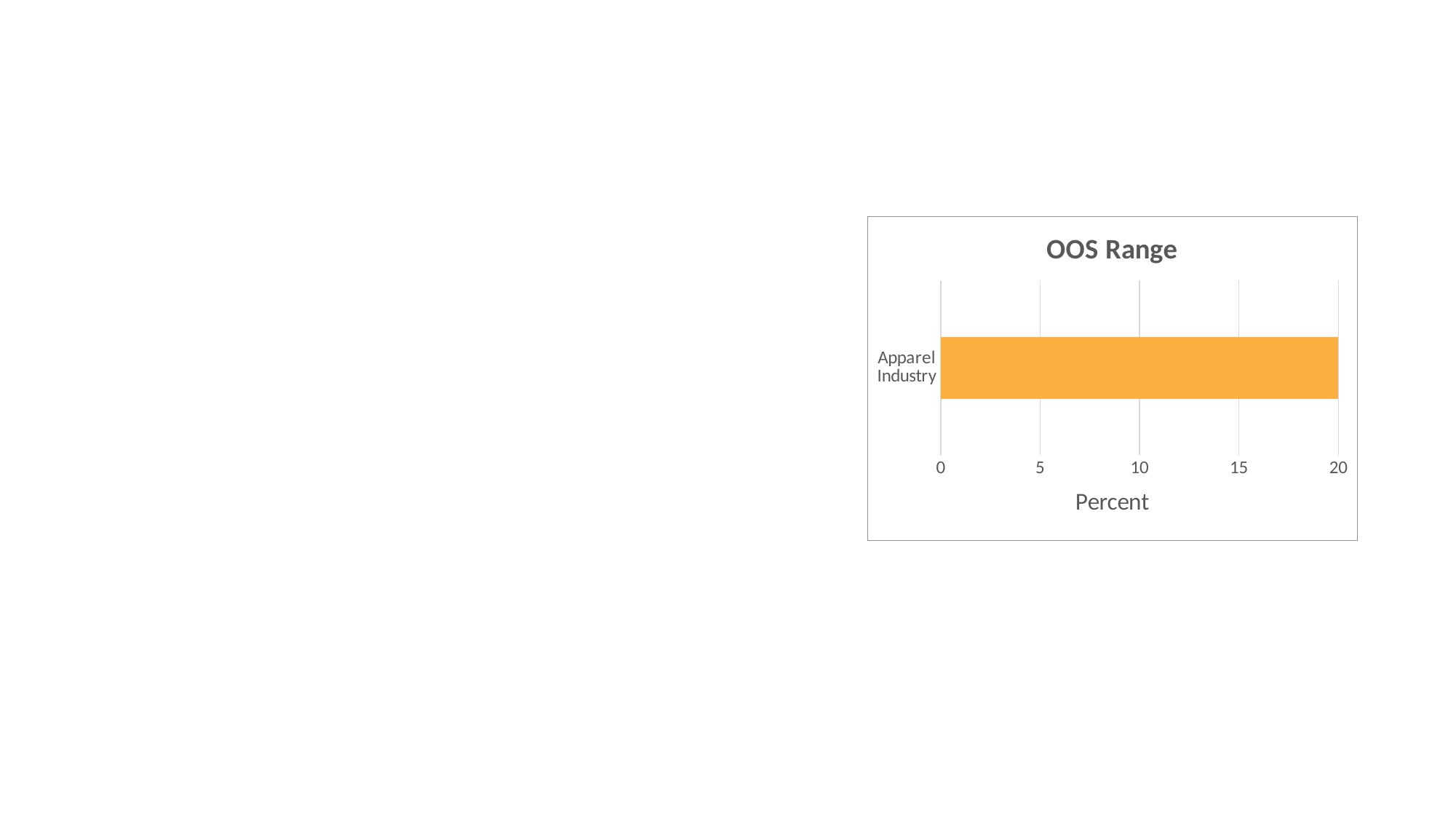
What is the value for Apparel Industry? 20 Which category is plotted in the chart? Apparel Industry What is the title of the chart? OOS Range What kind of chart is shown on the slide? bar chart Is the value for Apparel Industry greater or less than 10? greater Is the value for Apparel Industry greater or less than 15? greater How many categories are plotted in the chart? 1 What is the highest value shown on the horizontal axis? 20 What is the label of the horizontal axis? Percent